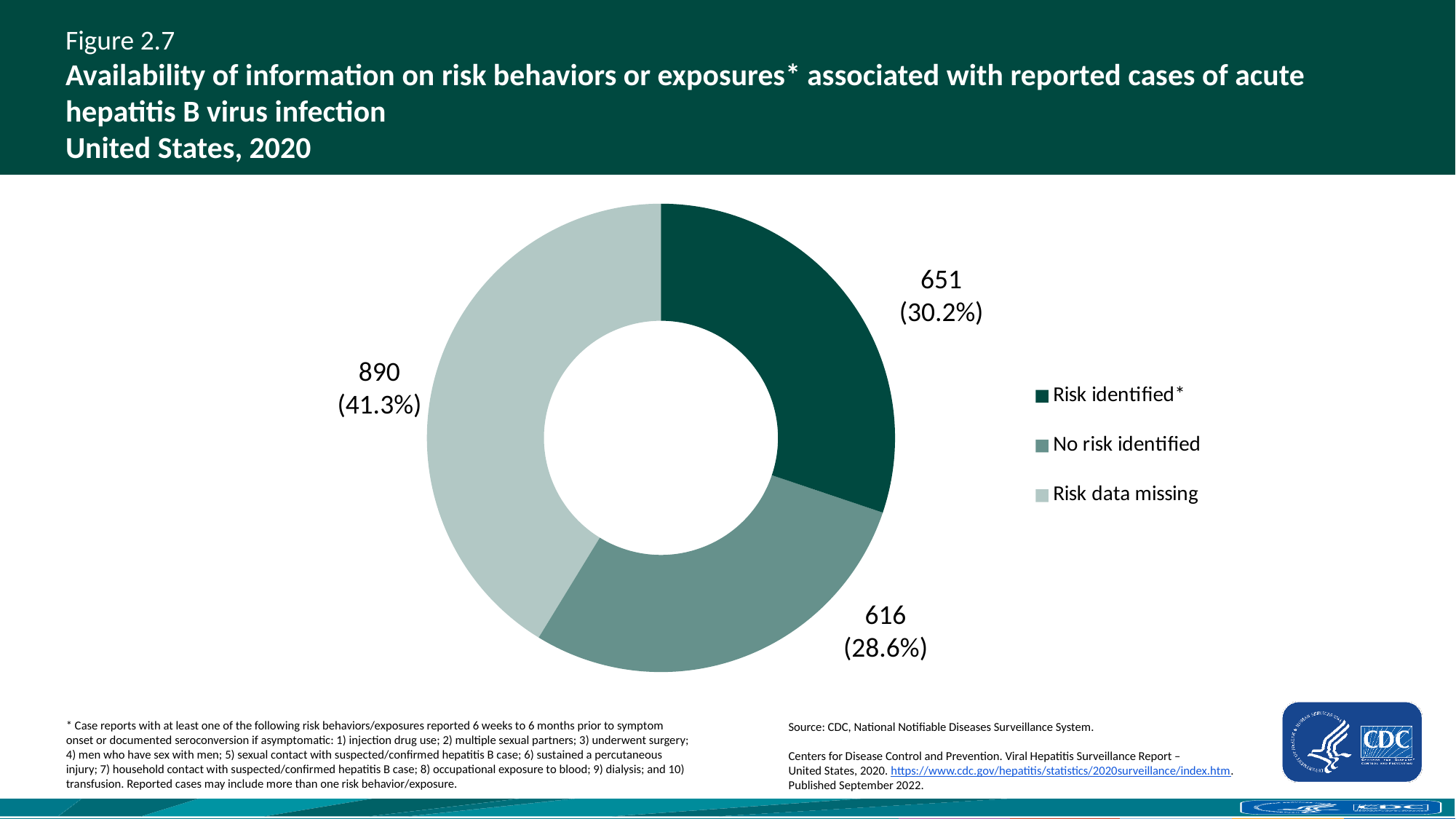
What share of cases does the 'No risk identified' slice represent? 28.6% Which category has the largest number of cases? Risk data missing What is the difference in cases between 'Risk data missing' and 'Risk identified*'? 239 What kind of chart is shown on the slide? Pie chart (donut) How many categories does the legend list? 3 What share of cases does the 'Risk data missing' slice represent? 41.3% What is the total number of cases across all three slices? 2157 What share of cases does the 'Risk identified*' slice represent? 30.2% How many cases are in the 'Risk data missing' category? 890 How many cases are in the 'Risk identified*' category? 651 How many cases are in the 'No risk identified' category? 616 Which category has the smallest number of cases? No risk identified